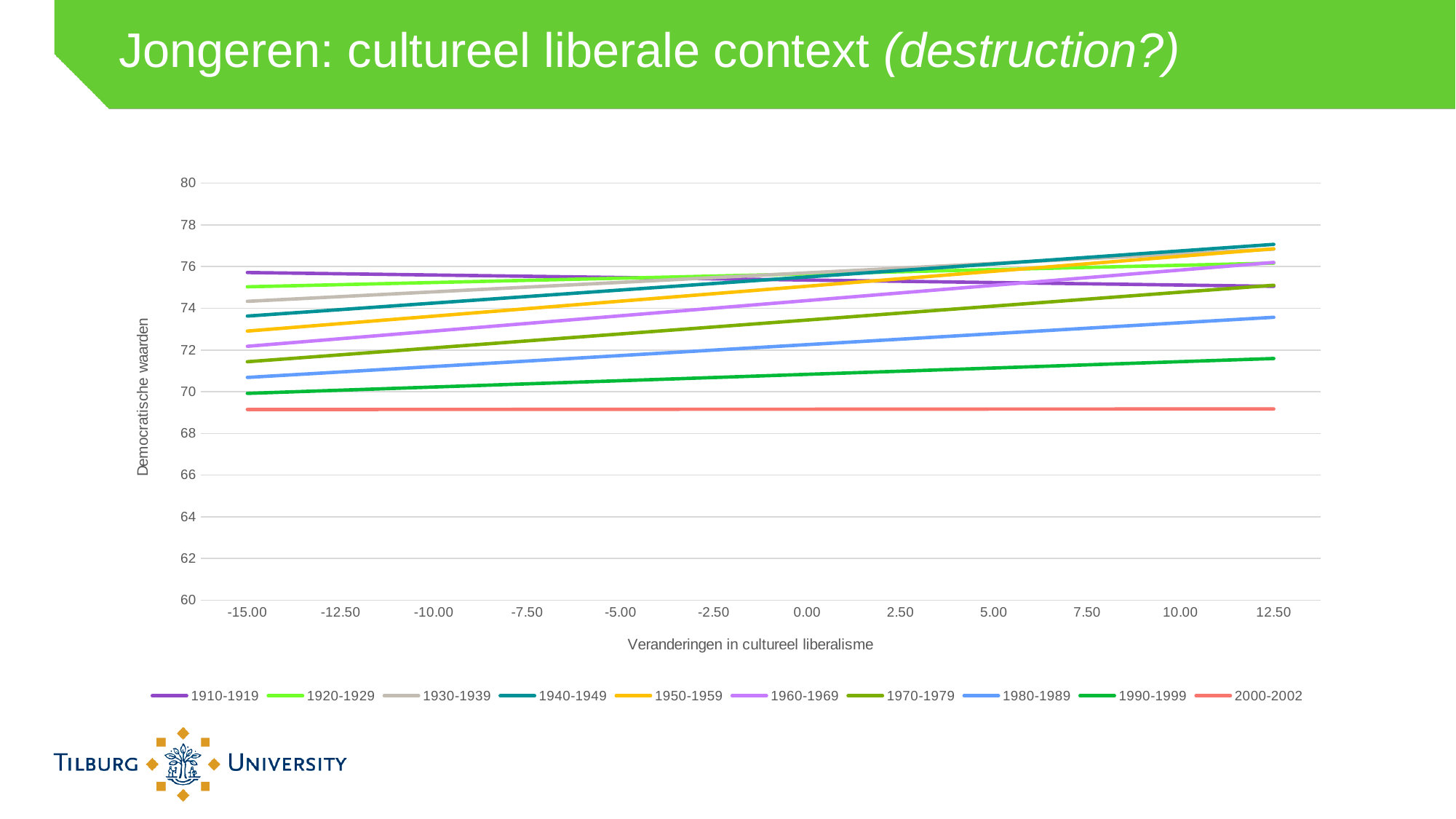
What kind of chart is shown on the slide? line chart Does the 1940-1949 line rise or fall as the x axis increases from -15.00 to 12.50? rise What is the title of the vertical axis? Democratische waarden Which series has the lowest values across the whole x axis? 2000-2002 Is the value for 1970-1979 at x = 12.50 greater or less than 74? greater Does the 1910-1919 line rise or fall as the x axis increases from -15.00 to 12.50? fall At x = 12.50, which is larger: the value for 1960-1969 or the value for 1990-1999? 1960-1969 Is the value for 2000-2002 at x = 12.50 greater or less than 70? less What is the title of the horizontal axis? Veranderingen in cultureel liberalisme Which series has the highest value at x = -15.00? 1910-1919 Is the value for 1950-1959 at x = -15.00 greater or less than 74? less How many series does the legend list? 10